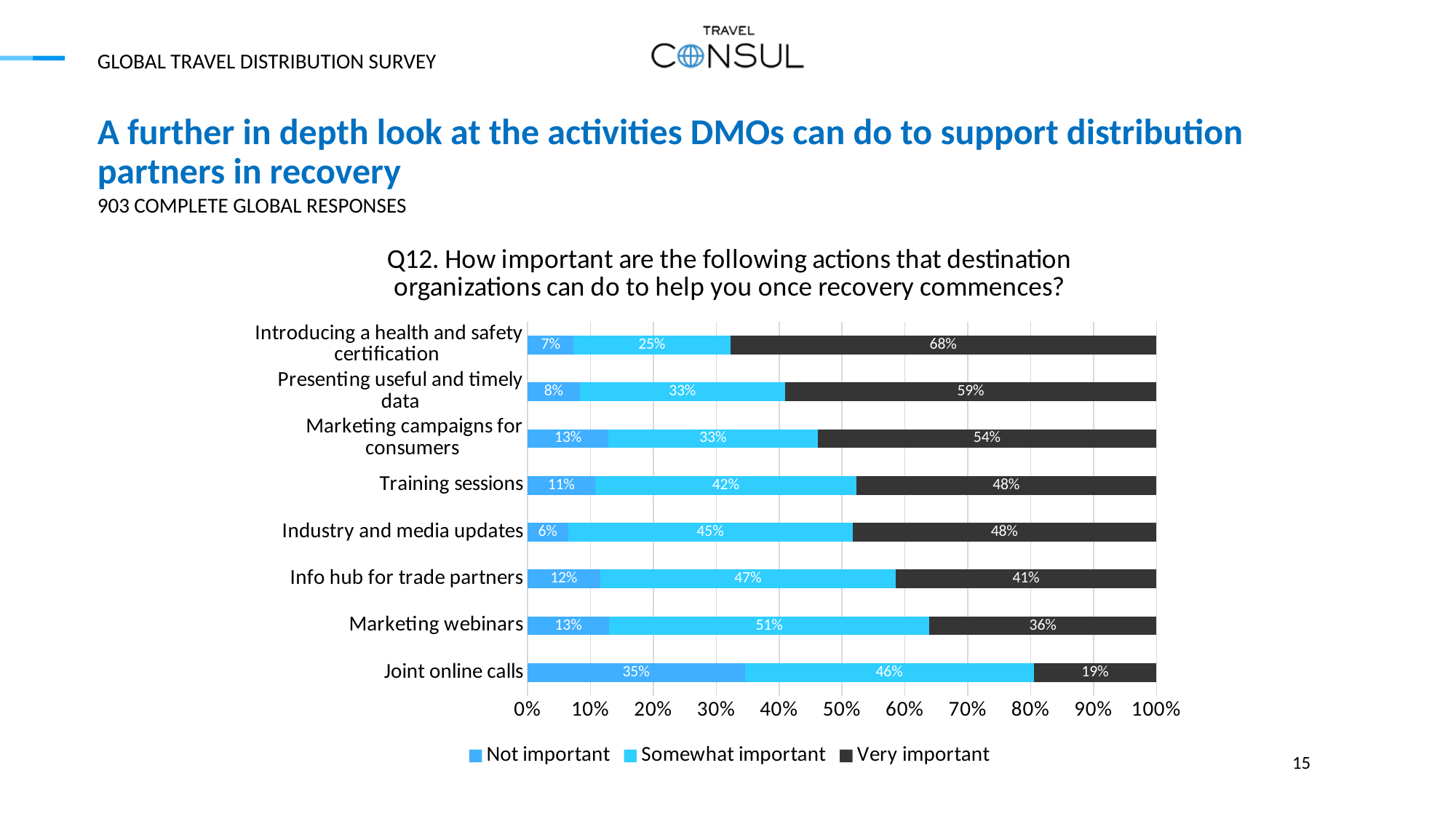
What is the title of the chart? Q12. How important are the following actions that destination organizations can do to help you once recovery commences? How many actions are listed on the chart? 8 Which action has the lowest 'Very important' percentage? Joint online calls Which has a larger 'Somewhat important' percentage: 'Info hub for trade partners' or 'Training sessions'? Info hub for trade partners Which action has the highest 'Not important' percentage? Joint online calls What percentage of respondents rated 'Joint online calls' as Not important? 35% What percentage of respondents rated 'Marketing webinars' as Somewhat important? 51% What is the difference between the 'Very important' percentages for 'Presenting useful and timely data' and 'Marketing campaigns for consumers'? 5% What kind of chart is shown on the slide? Stacked bar chart Which action has the highest 'Very important' percentage? Introducing a health and safety certification What percentage of respondents rated 'Introducing a health and safety certification' as Very important? 68% How many series does the legend list? 3